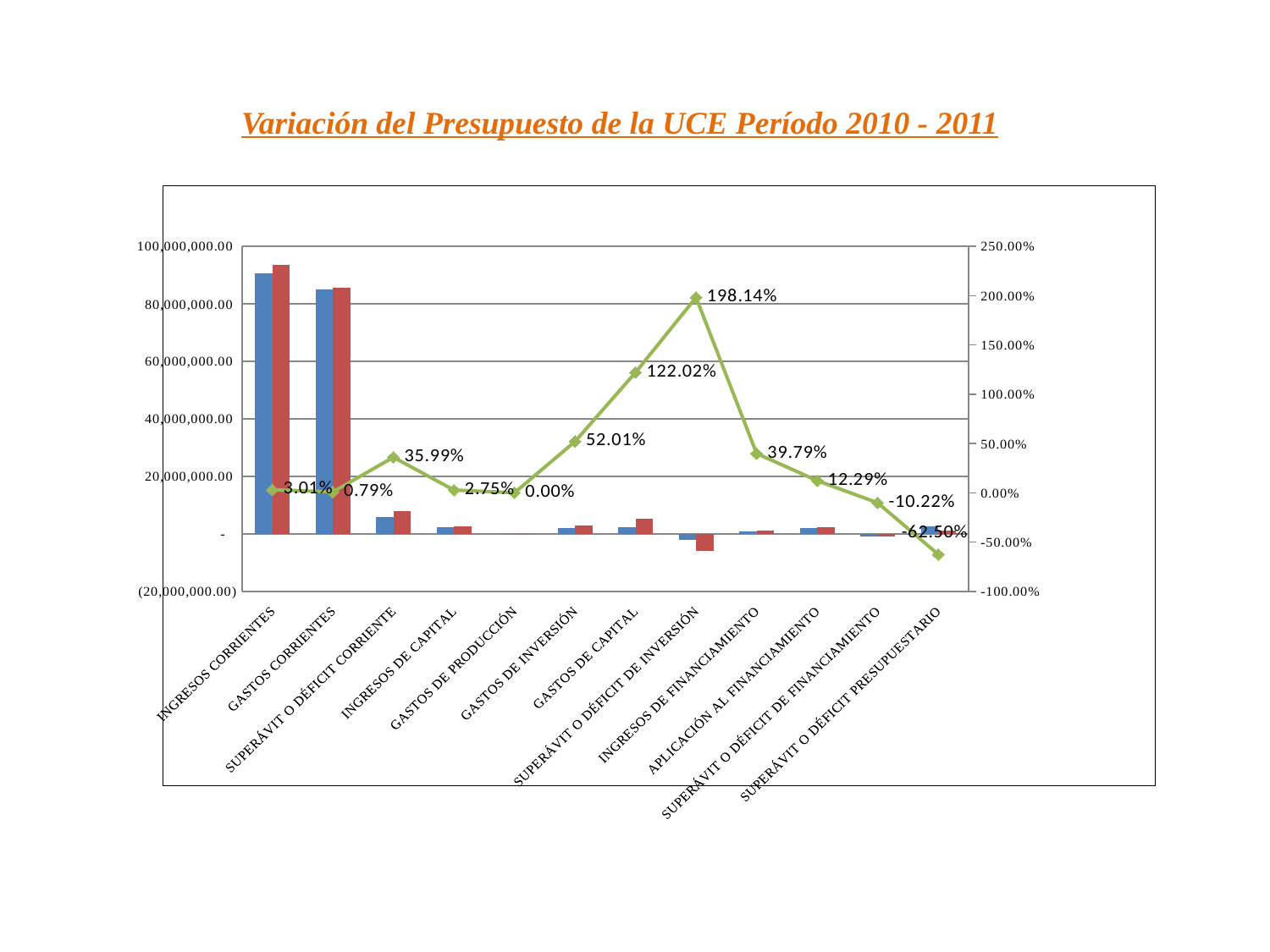
Which has the larger percentage value on the line, GASTOS DE INVERSIÓN or INGRESOS DE FINANCIAMIENTO? GASTOS DE INVERSIÓN Which category has the highest percentage value on the line? SUPERÁVIT O DÉFICIT DE INVERSIÓN What percentage value is labelled on the line for GASTOS DE CAPITAL? 122.02% How many categories are shown on the x axis? 12 Is the value of the blue bar for INGRESOS CORRIENTES greater or less than 80,000,000.00? greater What is the difference in percentage points between the line values for SUPERÁVIT O DÉFICIT DE INVERSIÓN and GASTOS DE CAPITAL? 76.12 percentage points What percentage value is labelled on the line for SUPERÁVIT O DÉFICIT PRESUPUESTARIO? -62.50% What percentage value is labelled on the line for SUPERÁVIT O DÉFICIT DE INVERSIÓN? 198.14% What kind of chart is shown on the slide? A combined bar and line chart What is the title of the slide? Variación del Presupuesto de la UCE Período 2010 - 2011 Which category has the lowest percentage value on the line? SUPERÁVIT O DÉFICIT PRESUPUESTARIO What percentage value is labelled on the line for GASTOS DE PRODUCCIÓN? 0.00%